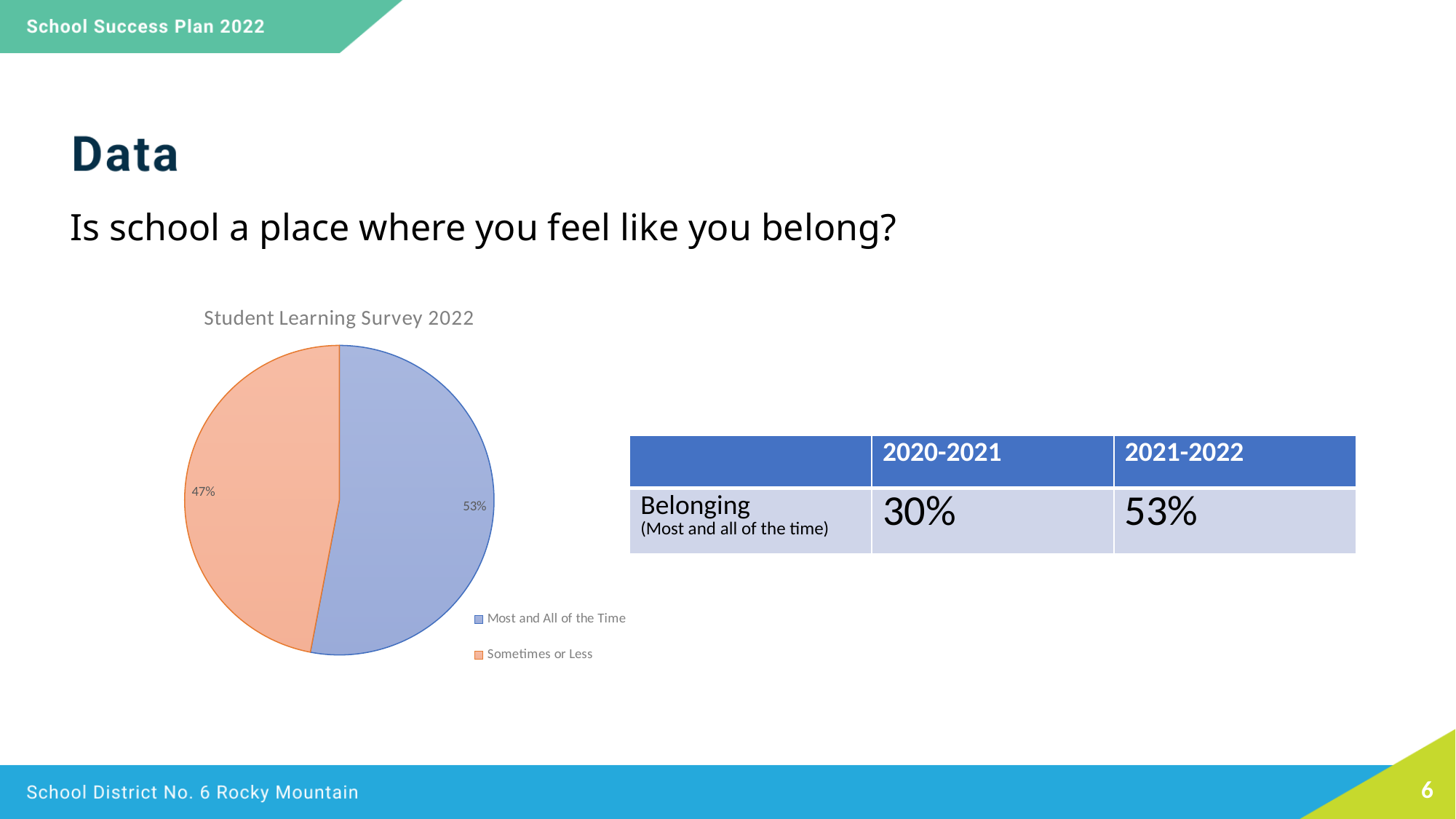
What type of chart is shown on the slide? pie chart How many slices does the pie chart have? 2 What is the difference in percentage points between the "Most and All of the Time" slice and the "Sometimes or Less" slice? 6 What colour is the "Sometimes or Less" slice? orange Which slice of the pie is the largest? Most and All of the Time What percentage of the pie is labelled "Sometimes or Less"? 47% What share of the pie does the "Most and All of the Time" slice represent? 53% What percentage of the pie is labelled "Most and All of the Time"? 53% What is the title of the chart? Student Learning Survey 2022 How many entries does the legend list? 2 Which is larger, the "Most and All of the Time" slice or the "Sometimes or Less" slice? Most and All of the Time Which slice of the pie is the smallest? Sometimes or Less